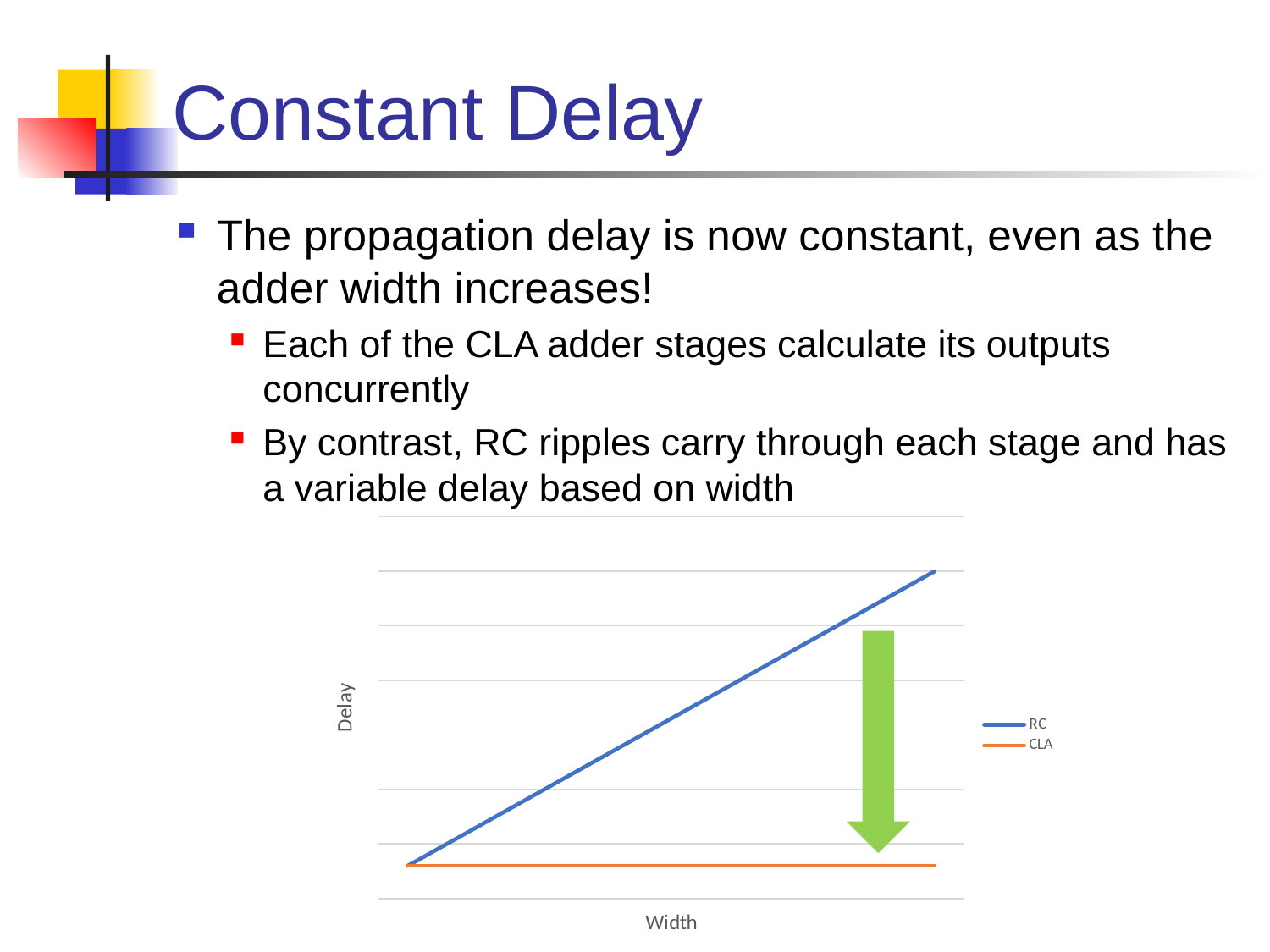
Does the CLA line rise, fall, or stay flat as Width increases along the x axis? stay flat Which series has the lowest delay at the right end of the chart? CLA Does the RC line rise or fall as Width increases along the x axis? rise Which two series are listed in the chart's legend? RC and CLA At the largest width shown, which series has the higher delay, RC or CLA? RC How many series does the chart's legend list? 2 Which series reaches the highest delay on the chart? RC What kind of chart is shown on the slide? line chart What is the label on the chart's vertical axis? Delay